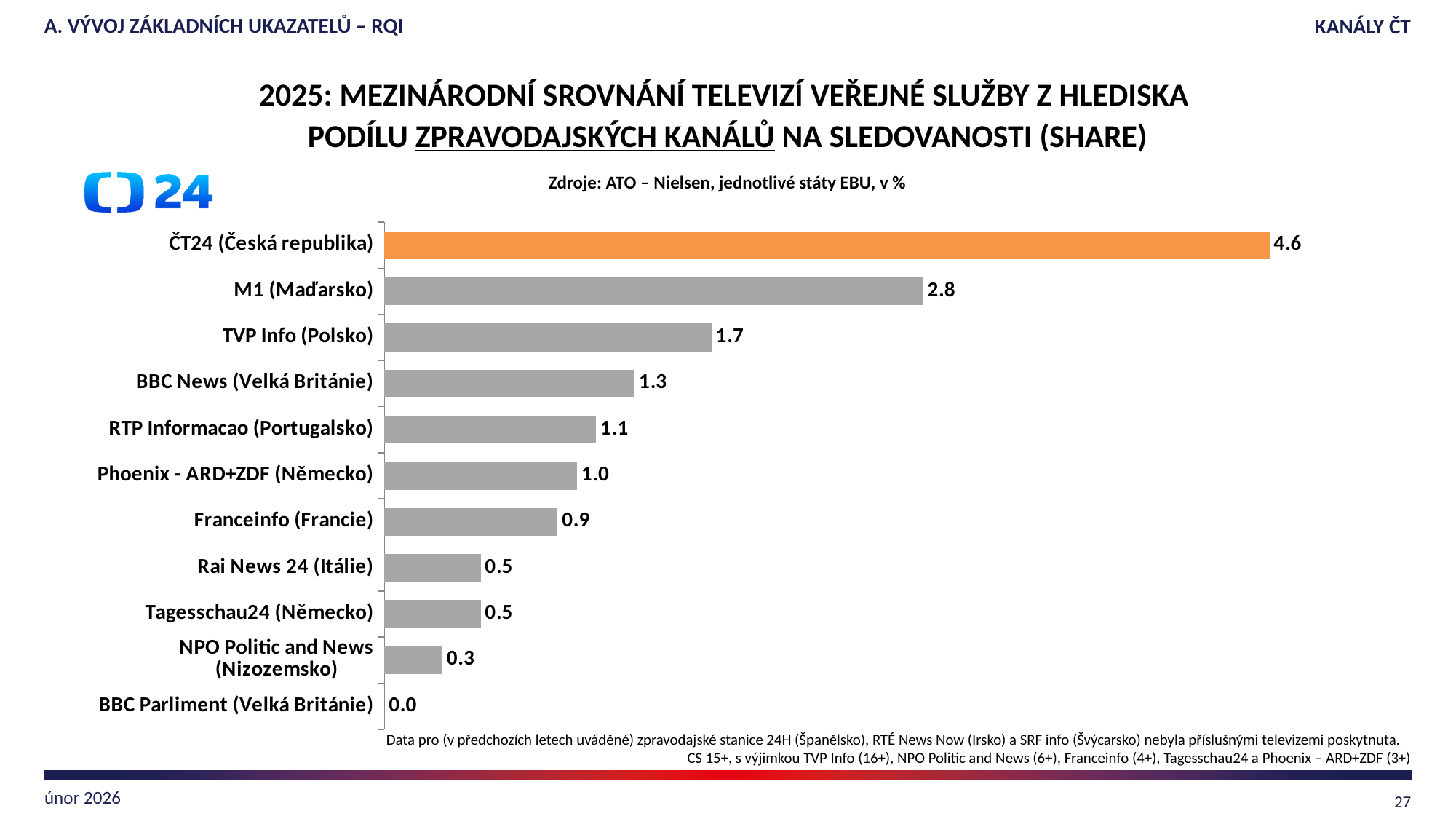
What is the value for Franceinfo (Francie)? 0.9 What is the difference between the values for BBC News (Velká Británie) and RTP Informacao (Portugalsko)? 0.2 Which has a larger value, M1 (Maďarsko) or TVP Info (Polsko)? M1 (Maďarsko) Which channel has the lowest value? BBC Parliment (Velká Británie) What is the value for TVP Info (Polsko)? 1.7 Which bar is coloured orange rather than grey? ČT24 (Česká republika) What kind of chart is shown on the slide? Bar chart How many channels are shown in the chart? 11 What is the value for ČT24 (Česká republika)? 4.6 What is the difference between the values for ČT24 (Česká republika) and M1 (Maďarsko)? 1.8 What is the value for NPO Politic and News (Nizozemsko)? 0.3 Which channel has the highest value? ČT24 (Česká republika)